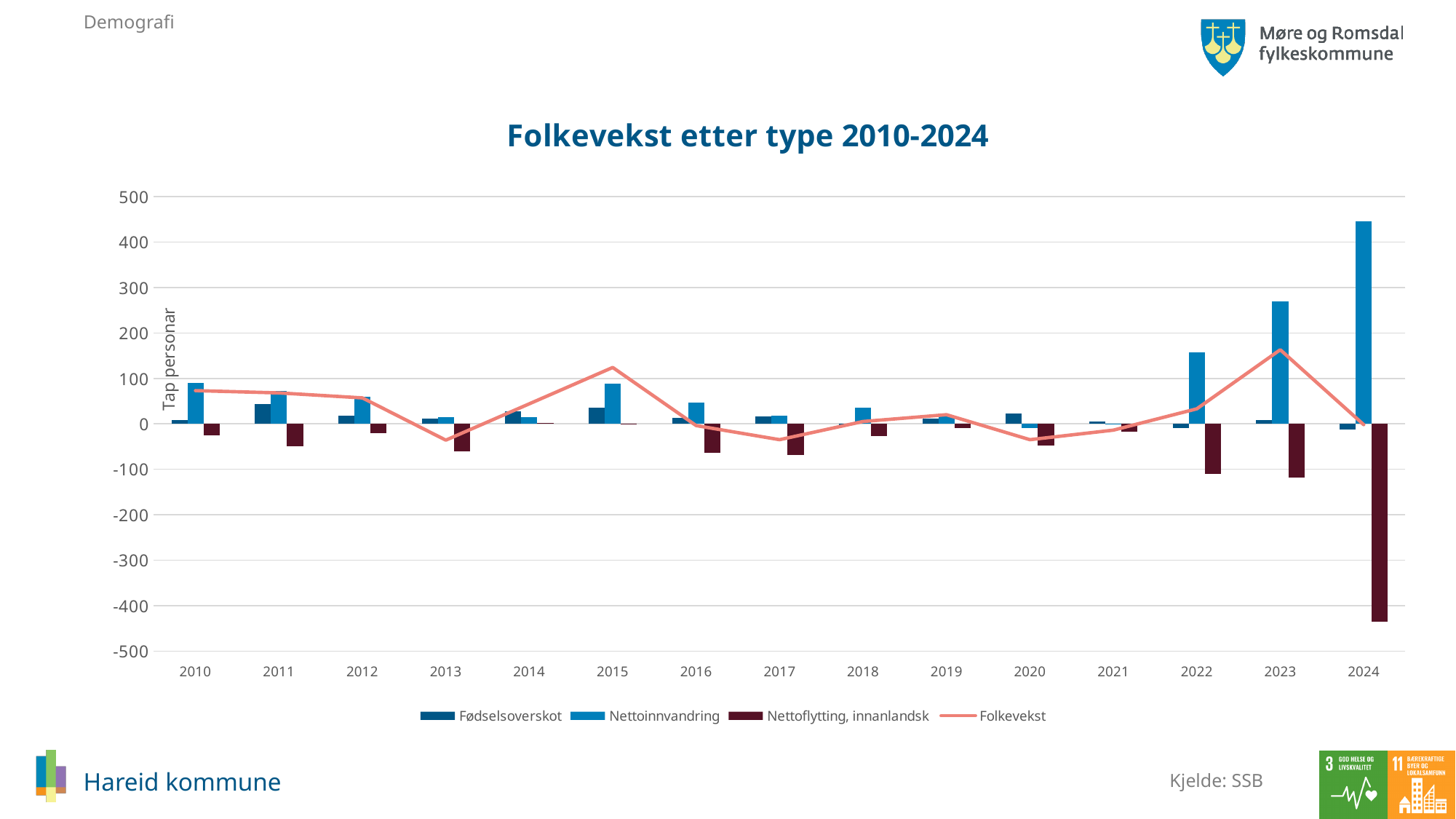
Which year has the larger Nettoinnvandring value, 2022 or 2023? 2023 Is the value for Nettoinnvandring in 2024 greater or less than 400? greater How many years are shown on the x axis? 15 Is the value for Nettoinnvandring in 2023 greater or less than 200? greater In which year does the Folkevekst line reach its highest point? 2023 In which year is Nettoflytting, innanlandsk lowest? 2024 Is the Folkevekst value in 2015 greater or less than 100? greater In which year is Nettoinnvandring highest? 2024 How many series does the legend list? 4 What kind of chart is shown on the slide? A combined bar and line chart Does the Nettoinnvandring value rise or fall from 2022 to 2024? rise